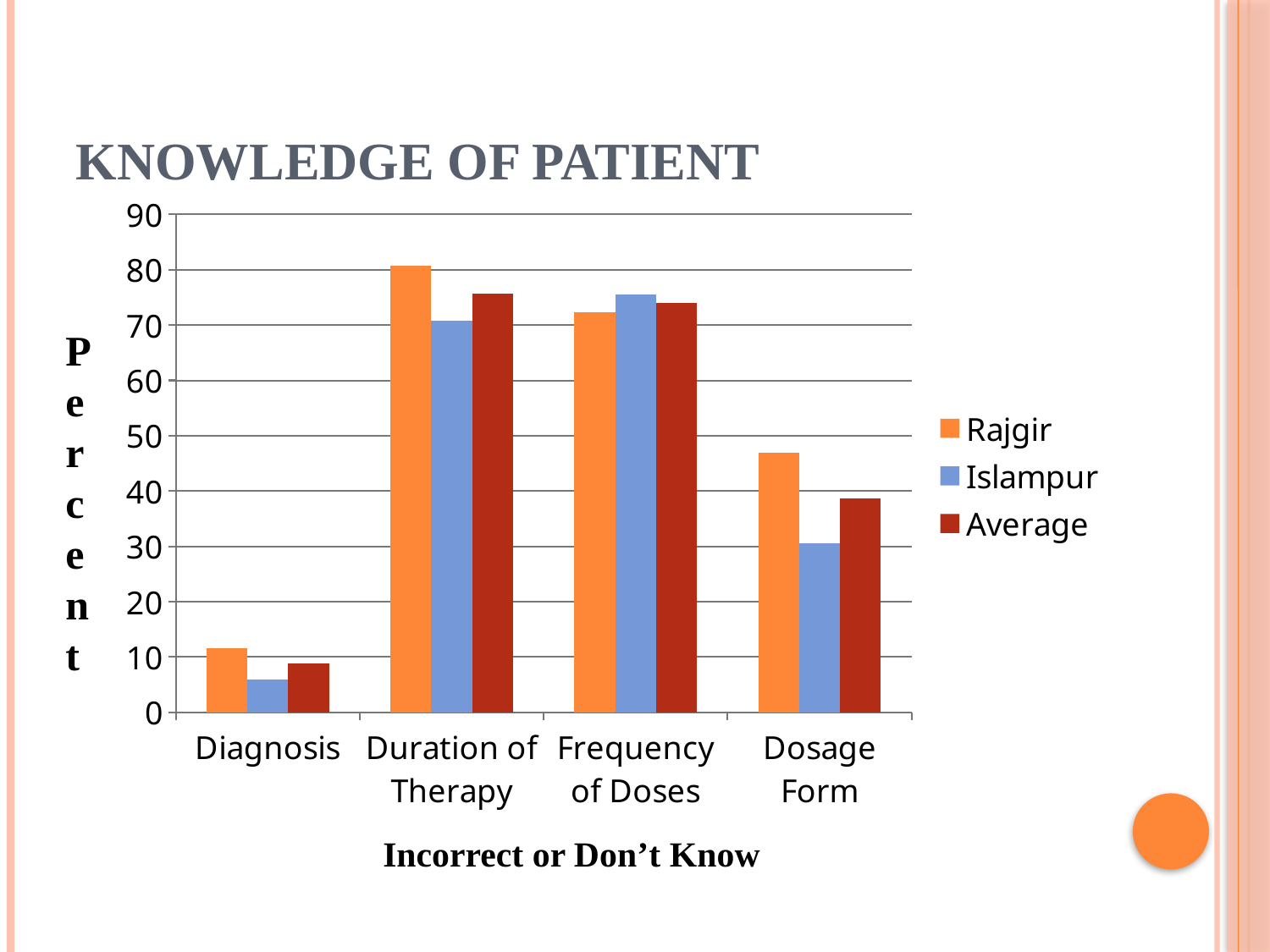
For which category is the Islampur value lowest? Diagnosis Is the Islampur value for Diagnosis greater or less than 10? less How many categories are shown on the x axis? 4 What is the label shown below the x axis categories? Incorrect or Don't Know For which category is the Rajgir value highest? Duration of Therapy Is the Islampur value for Dosage Form greater or less than 40? less For Frequency of Doses, which is larger: the Rajgir value or the Islampur value? Islampur Is the Rajgir value for Dosage Form greater or less than 40? greater How many series does the legend list? 3 What is the title of the chart? KNOWLEDGE OF PATIENT What kind of chart is shown on the slide? bar chart For Dosage Form, which is larger: the Rajgir value or the Islampur value? Rajgir